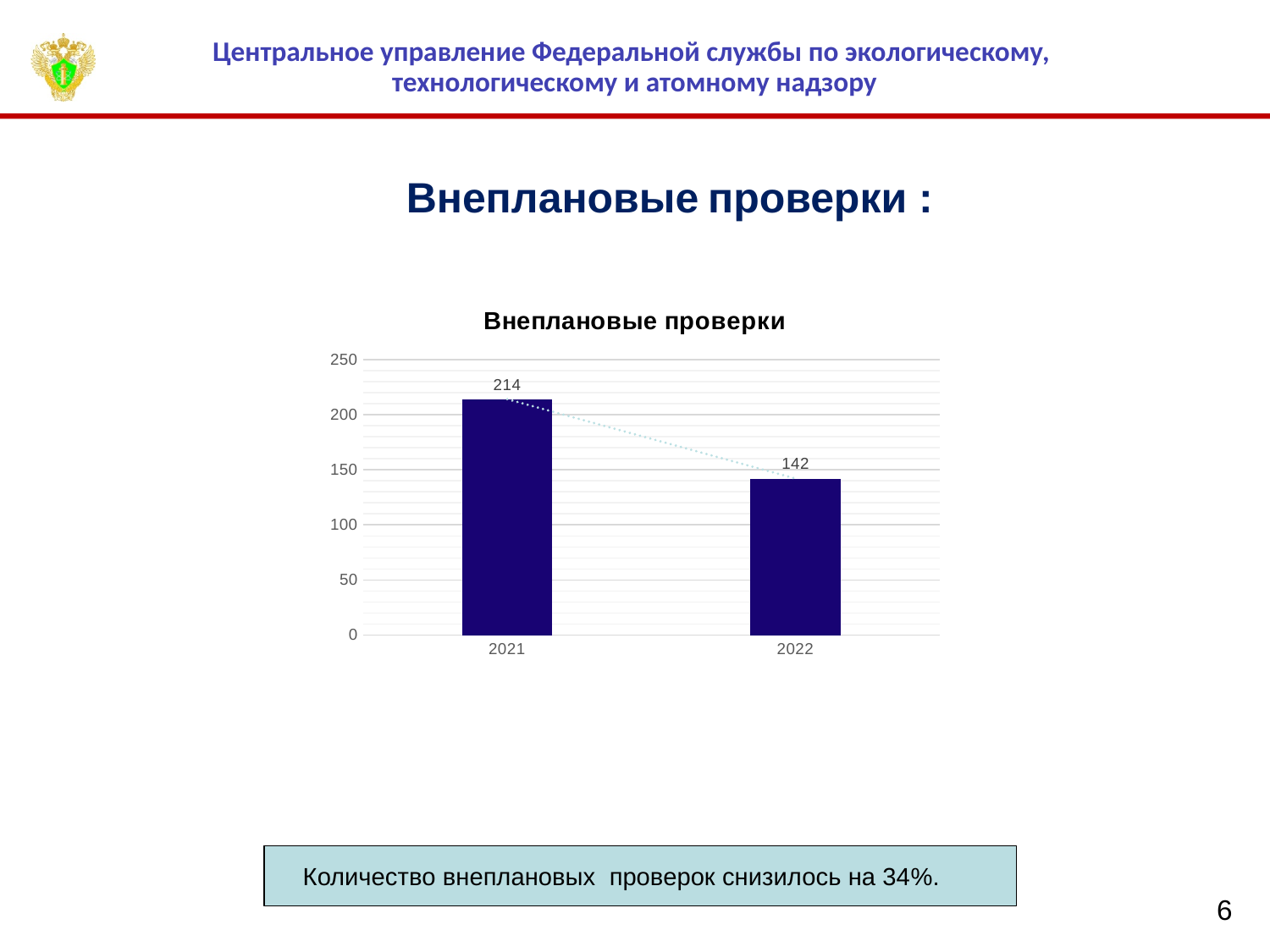
How many years are shown on the x axis of the chart? 2 What is the value for 2021 in the chart? 214 Which year has the highest value in the chart? 2021 Which is larger, the value for 2021 or the value for 2022? 2021 Do the values rise or fall from 2021 to 2022? fall What is the difference between the values for 2021 and 2022? 72 What is the value for 2022 in the chart? 142 Is the value for 2022 greater or less than 150? less Which year has the lowest value in the chart? 2022 What kind of chart is shown on the slide? bar chart What is the title of the chart? Внеплановые проверки Is the value for 2021 greater or less than 200? greater